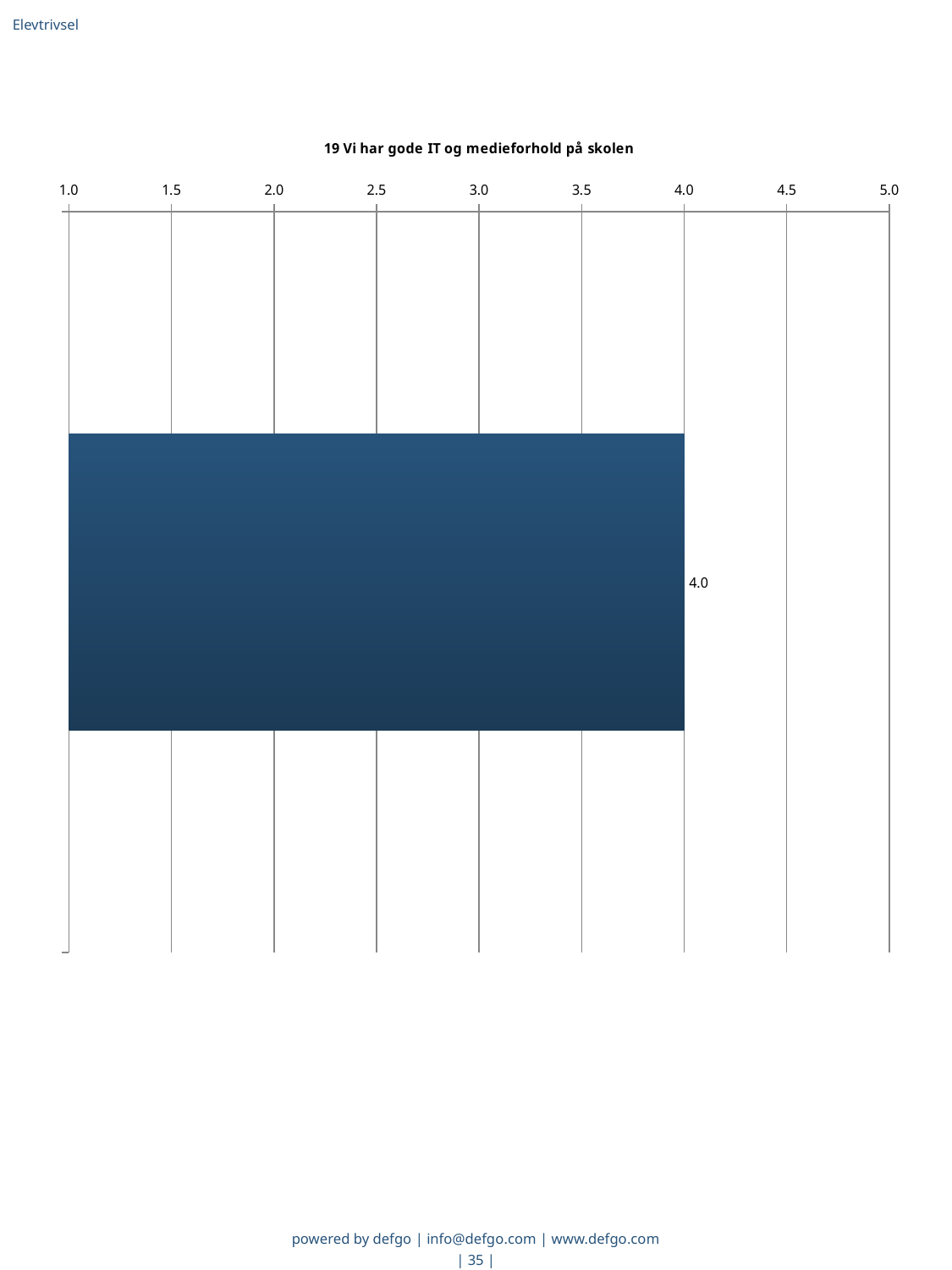
How many bars are plotted in the chart? 1 What is the title of the chart? 19 Vi har gode IT og medieforhold på skolen What is the highest value shown on the chart's axis? 5.0 Is the value of the bar greater or less than 4.5? less What is the lowest value shown on the chart's axis? 1.0 What kind of chart is shown on the slide? bar chart What is the value shown by the bar in the chart? 4.0 Is the value of the bar greater or less than 3.5? greater